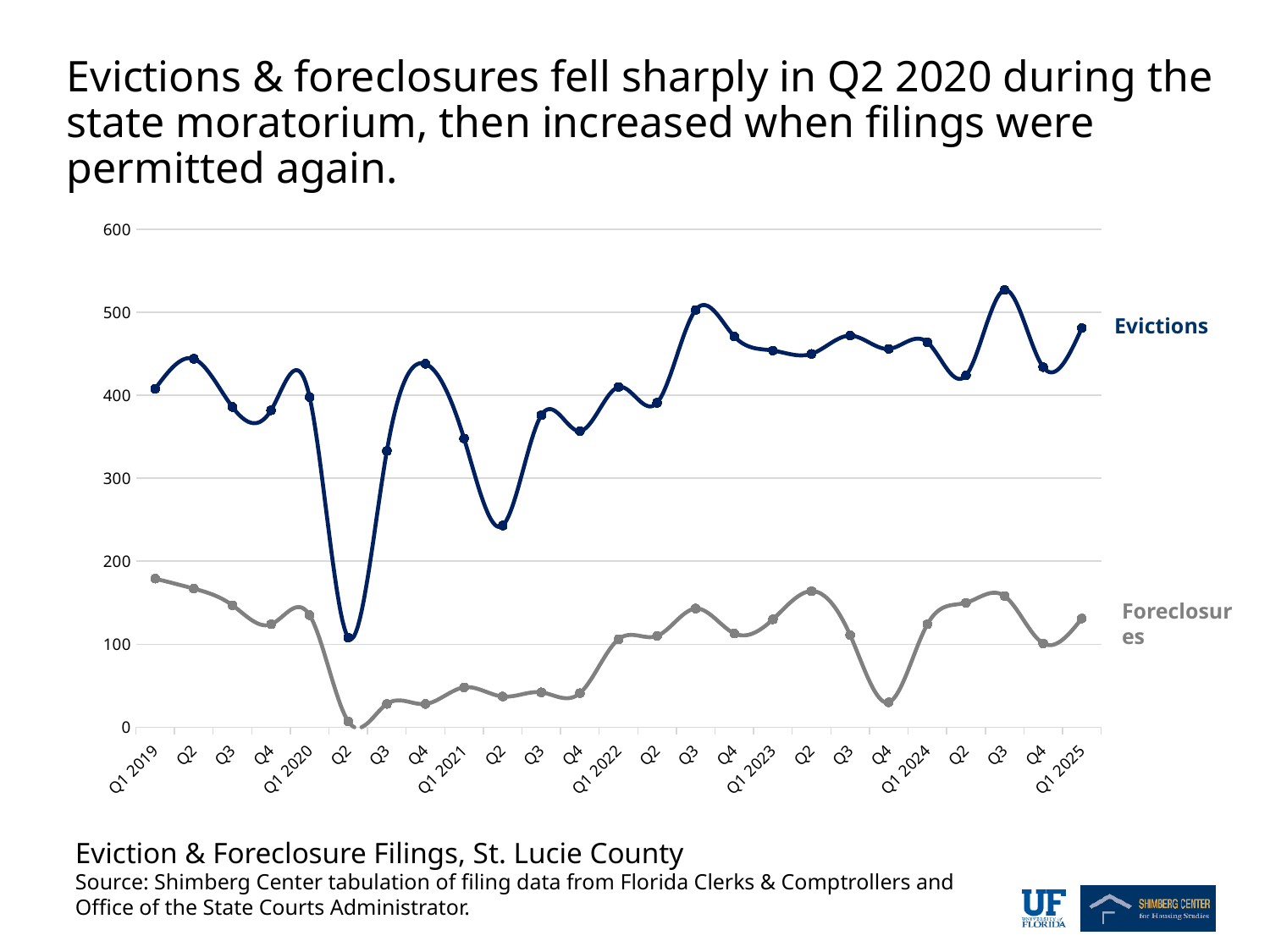
How many series does the chart show? 2 What is the title of the chart? Eviction & Foreclosure Filings, St. Lucie County What kind of chart is shown on the slide? Line chart Do Foreclosures rise or fall from Q1 2019 to Q2 2020? Fall Is the value for Foreclosures in Q1 2025 greater or less than 100? greater What are the two series plotted on the chart? Evictions and Foreclosures In which quarter do Evictions reach their highest value? Q3 2024 Which series has the larger value in Q1 2022, Evictions or Foreclosures? Evictions In which quarter do Evictions reach their lowest value? Q2 2020 How many quarterly data points does each series have, from Q1 2019 to Q1 2025? 25 Is the value for Evictions in Q2 2020 greater or less than 200? less In which quarter do Foreclosures reach their lowest value? Q2 2020